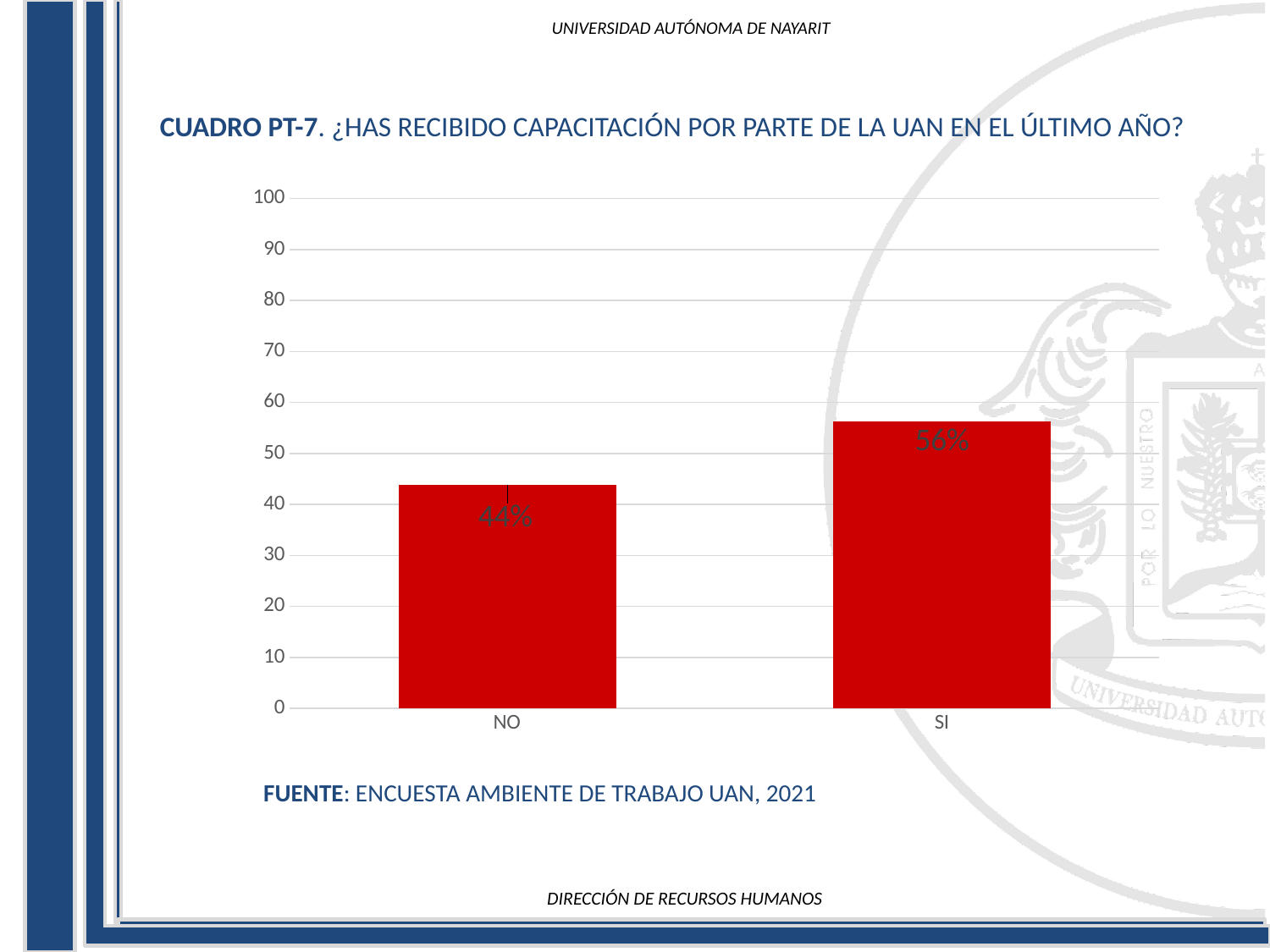
Is the value for NO greater or less than 50? less What is the value for SI? 56% Is the value for SI greater or less than 50? greater Which category has the highest value? SI What kind of chart is shown on the slide? bar chart What is the maximum value shown on the y axis? 100 Which category has the lowest value? NO What is the difference between the values for SI and NO? 12% What is the source cited below the chart? ENCUESTA AMBIENTE DE TRABAJO UAN, 2021 Which is larger, the value for NO or the value for SI? SI How many categories are shown on the x axis? 2 What is the value for NO? 44%